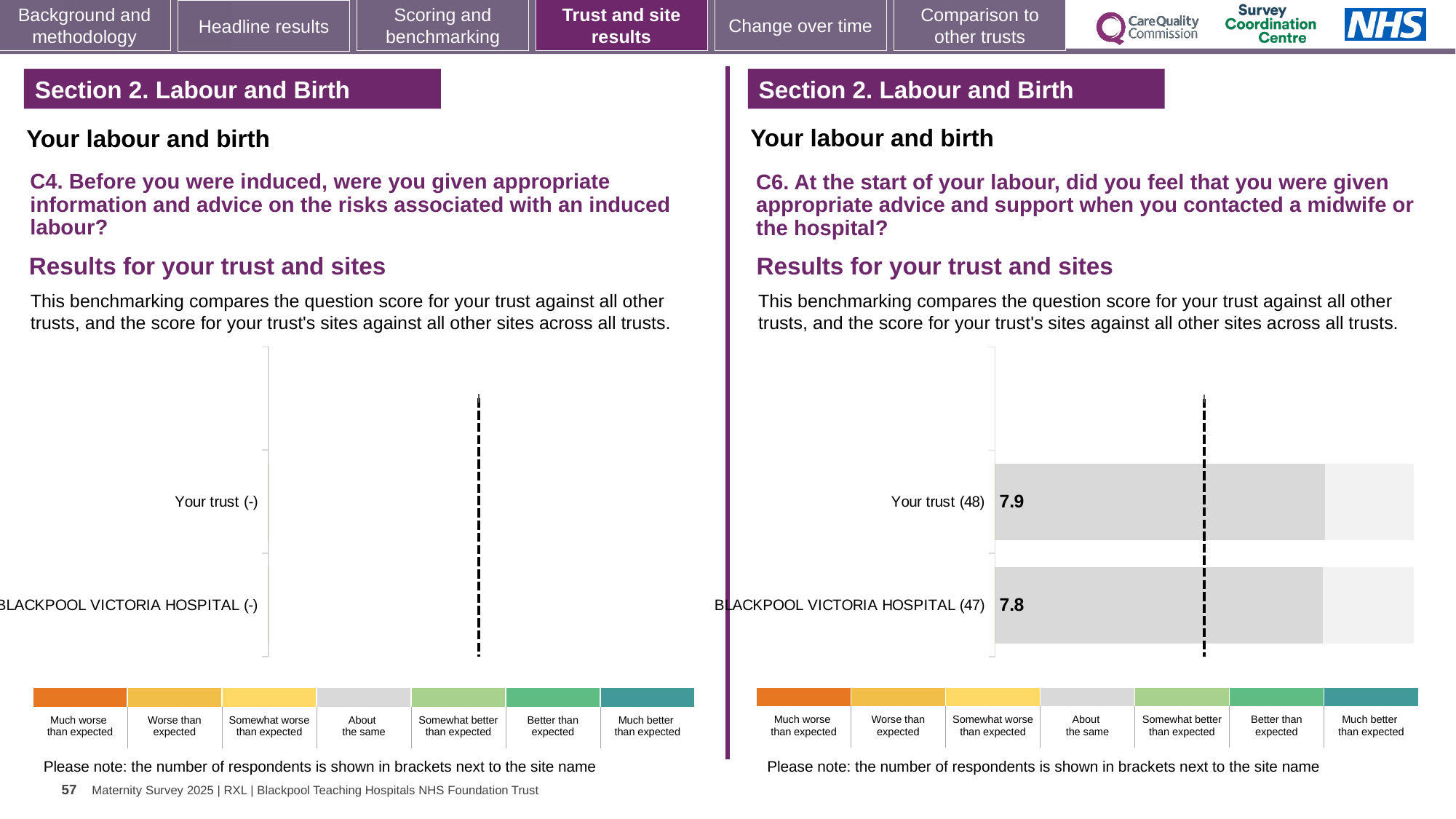
In the right-hand chart (C6), which category has the lowest score? BLACKPOOL VICTORIA HOSPITAL How many categories does the colour key below the right-hand chart (C6) list? 7 In the right-hand chart (C6), what is the score for Your trust? 7.9 What kind of chart is shown on the right-hand side of the slide (C6)? Bar chart In the right-hand chart (C6), what is the score for BLACKPOOL VICTORIA HOSPITAL? 7.8 In the right-hand chart (C6), what is the difference between the score for Your trust and the score for BLACKPOOL VICTORIA HOSPITAL? 0.1 In the right-hand chart (C6), how many respondents are shown in brackets for BLACKPOOL VICTORIA HOSPITAL? 47 In the left-hand chart (C4), what is shown in brackets next to Your trust? - In the left-hand chart (C4), how many categories are listed on the axis? 2 In the right-hand chart (C6), how many bars are plotted? 2 In the right-hand chart (C6), which has the higher score, Your trust or BLACKPOOL VICTORIA HOSPITAL? Your trust In the right-hand chart (C6), how many respondents are shown in brackets for Your trust? 48